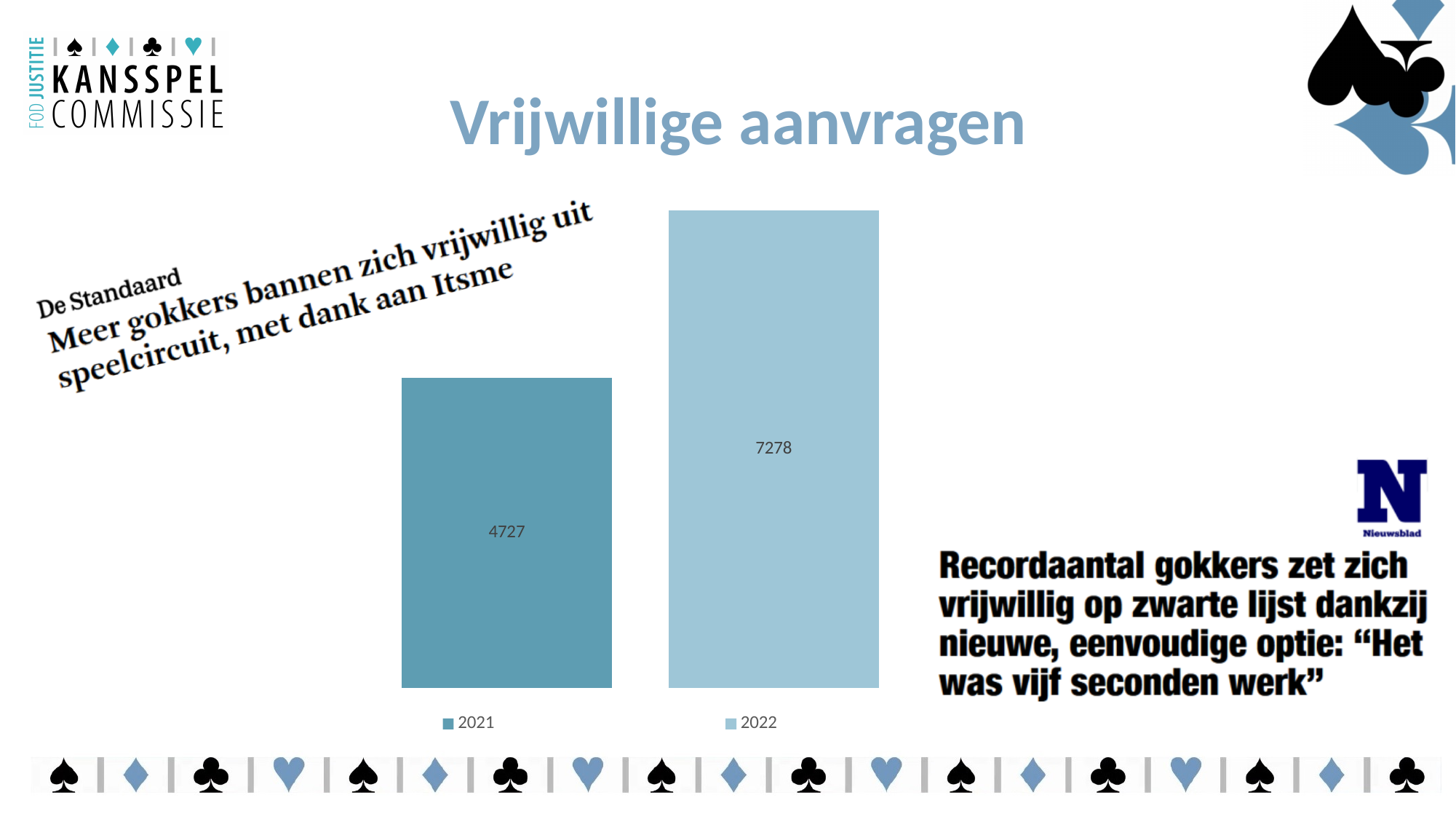
How many entries does the legend list? 2 What kind of chart is shown on the slide? Bar chart Is the value for 2022 larger than the value for 2021? Yes What is the difference between the 2022 and 2021 values? 2551 Which year has the higher value? 2022 What is the value for 2021? 4727 Which legend entry is shown in the darker blue colour? 2021 Which year has the lower value? 2021 What is the title of the slide containing the chart? Vrijwillige aanvragen What is the value for 2022? 7278 How many bars are shown in the chart? 2 Do the values rise or fall from 2021 to 2022? Rise